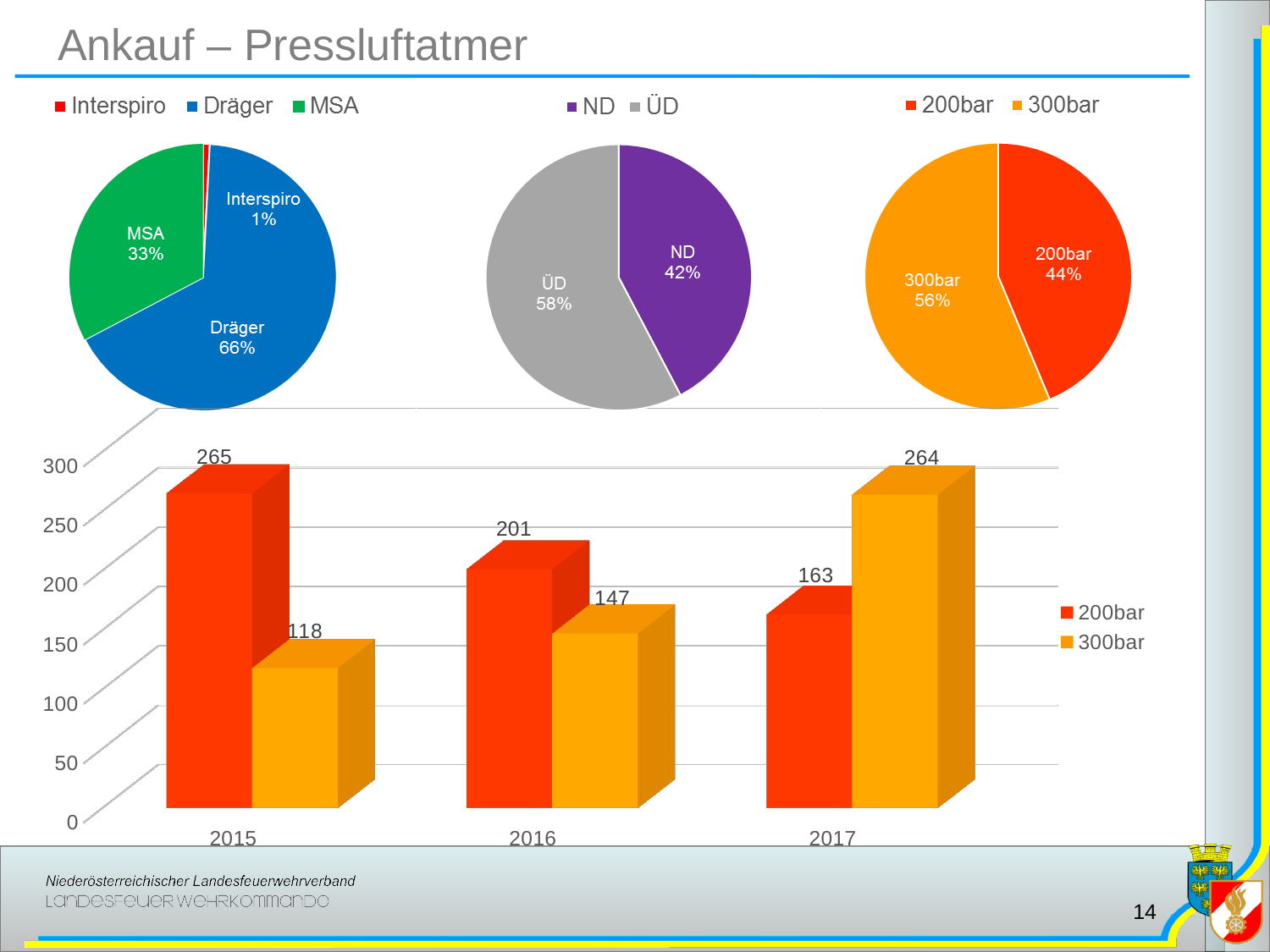
In the bottom bar chart, how many years are shown on the x axis? 3 In the bottom bar chart, what is the difference between the 200bar and 300bar values in 2016? 54 In the bottom bar chart, which is larger in 2017, 200bar or 300bar? 300bar In the left pie chart (Interspiro/Dräger/MSA), what share does Dräger have? 66% In the bottom bar chart, does the 300bar value rise or fall from 2015 to 2017? rise In the middle pie chart (ND/ÜD), what share does ÜD have? 58% What kind of chart is the bottom chart on the slide? bar chart In the middle pie chart (ND/ÜD), which category has the larger share? ÜD In the right pie chart (200bar/300bar), what share does 200bar have? 44% In the left pie chart (Interspiro/Dräger/MSA), which category has the smallest share? Interspiro In the bottom bar chart, what is the value for 300bar in 2017? 264 In the bottom bar chart, what is the value for 200bar in 2015? 265